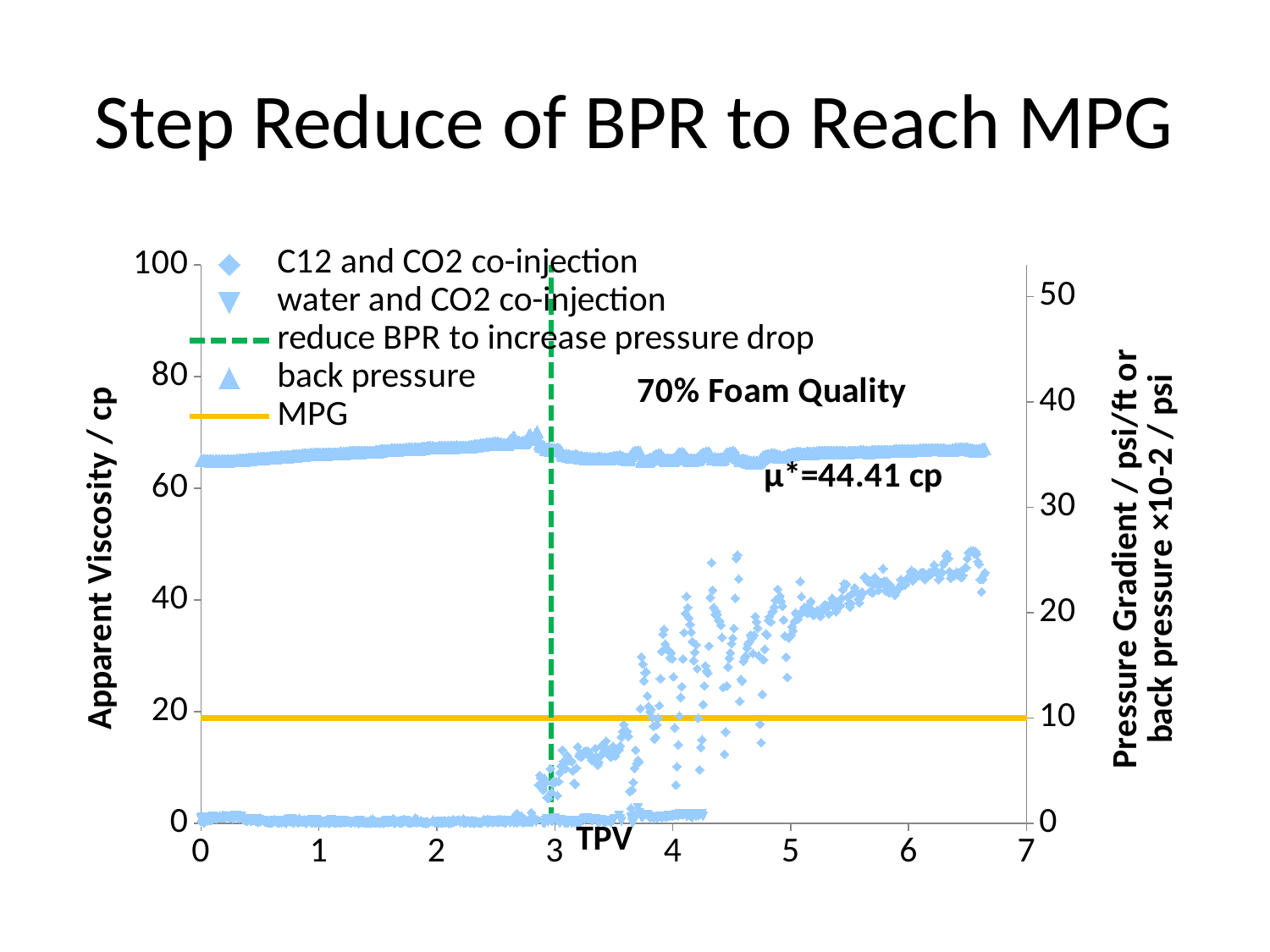
What value of μ* is annotated on the chart? 44.41 cp What is the highest tick value shown on the x axis? 7 What is the highest tick value shown on the right y axis? 50 What kind of chart is shown on the slide? scatter chart Do the C12 and CO2 co-injection values rise or fall as TPV increases from 3 to 6? rise What is the label of the x axis? TPV What foam quality is annotated on the chart? 70% How many entries does the chart legend list? 5 Is the TPV position of the dashed 'reduce BPR to increase pressure drop' line greater or less than 4? less What is the label of the left y axis? Apparent Viscosity / cp